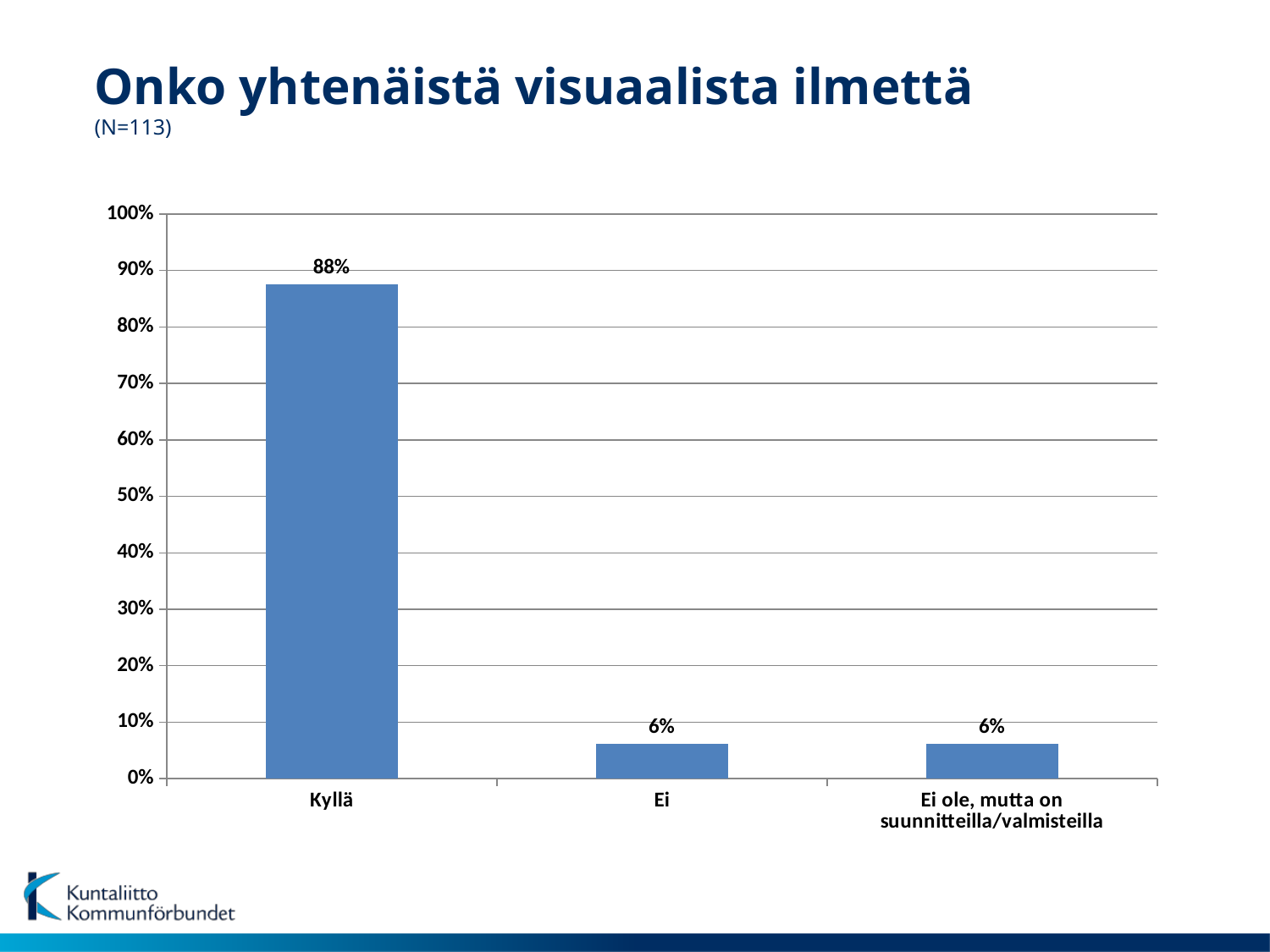
What is the value for Kyllä? 88% Is the value for Ei greater or less than 10%? less What is the value for 'Ei ole, mutta on suunnitteilla/valmisteilla'? 6% Which is larger, the value for Kyllä or the value for Ei? Kyllä How many categories are shown on the x axis? 3 What is the sample size (N) stated under the title? N=113 Is the value for Kyllä greater or less than 80%? greater What is the difference between the values for Kyllä and Ei? 82% What is the title of the slide? Onko yhtenäistä visuaalista ilmettä Which category has the highest value? Kyllä What is the value for Ei? 6% What kind of chart is shown on the slide? bar chart